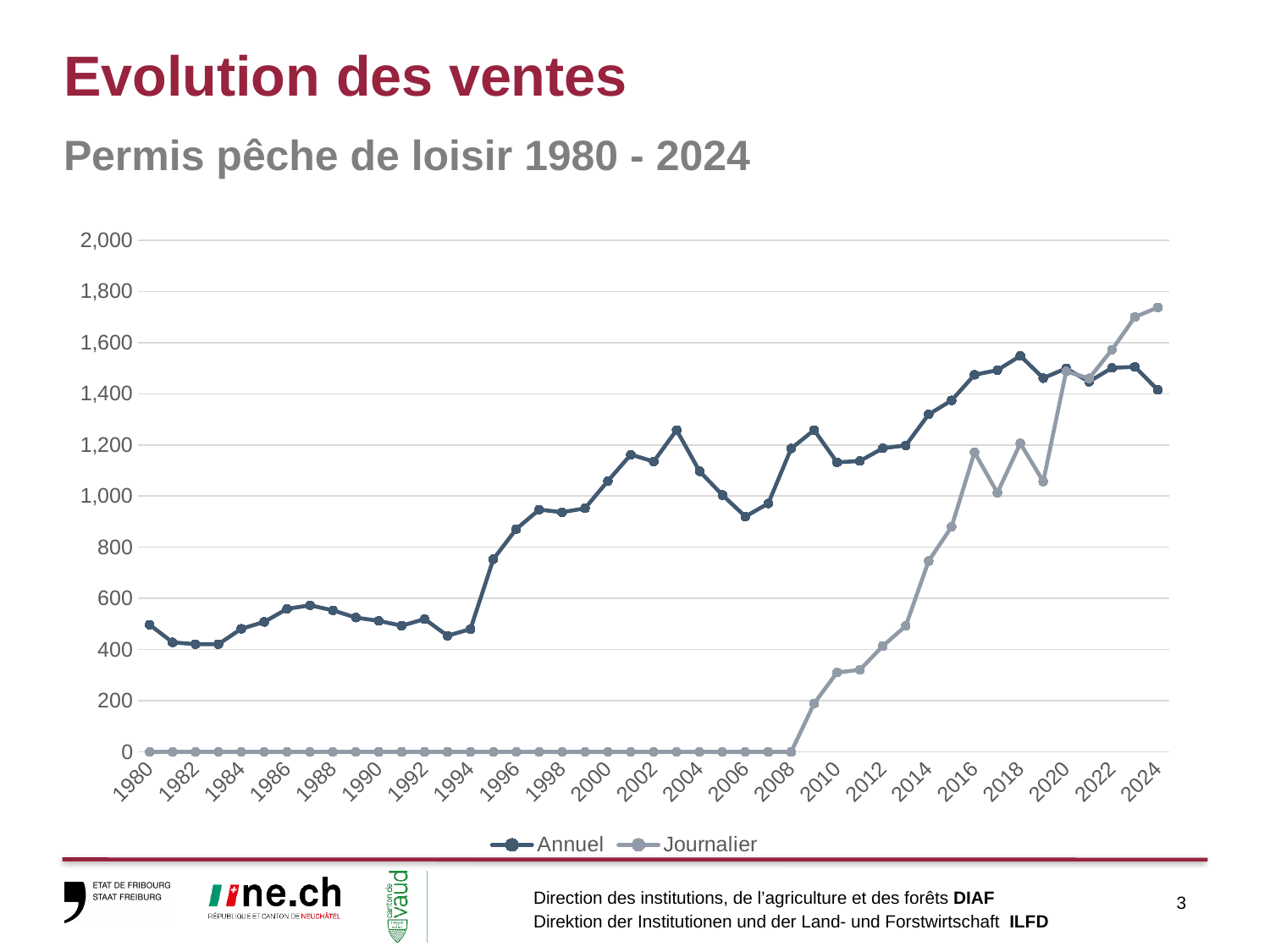
In which year does the Journalier series reach its highest value? 2024 Is the Annuel value for 1980 greater or less than 600? less How many series does the legend list? 2 In 2024, which series has the higher value, Annuel or Journalier? Journalier Is the Annuel value for 1995 greater or less than 600? greater In 2016, which series has the higher value, Annuel or Journalier? Annuel Does the Journalier series rise or fall between 2008 and 2024? rise What are the first and last years shown on the x axis? 1980 and 2024 What are the two series named in the legend? Annuel and Journalier What is the value of the Journalier series in 2000? 0 Is the Journalier value for 2024 greater or less than 1,600? greater What kind of chart is shown on the slide? line chart